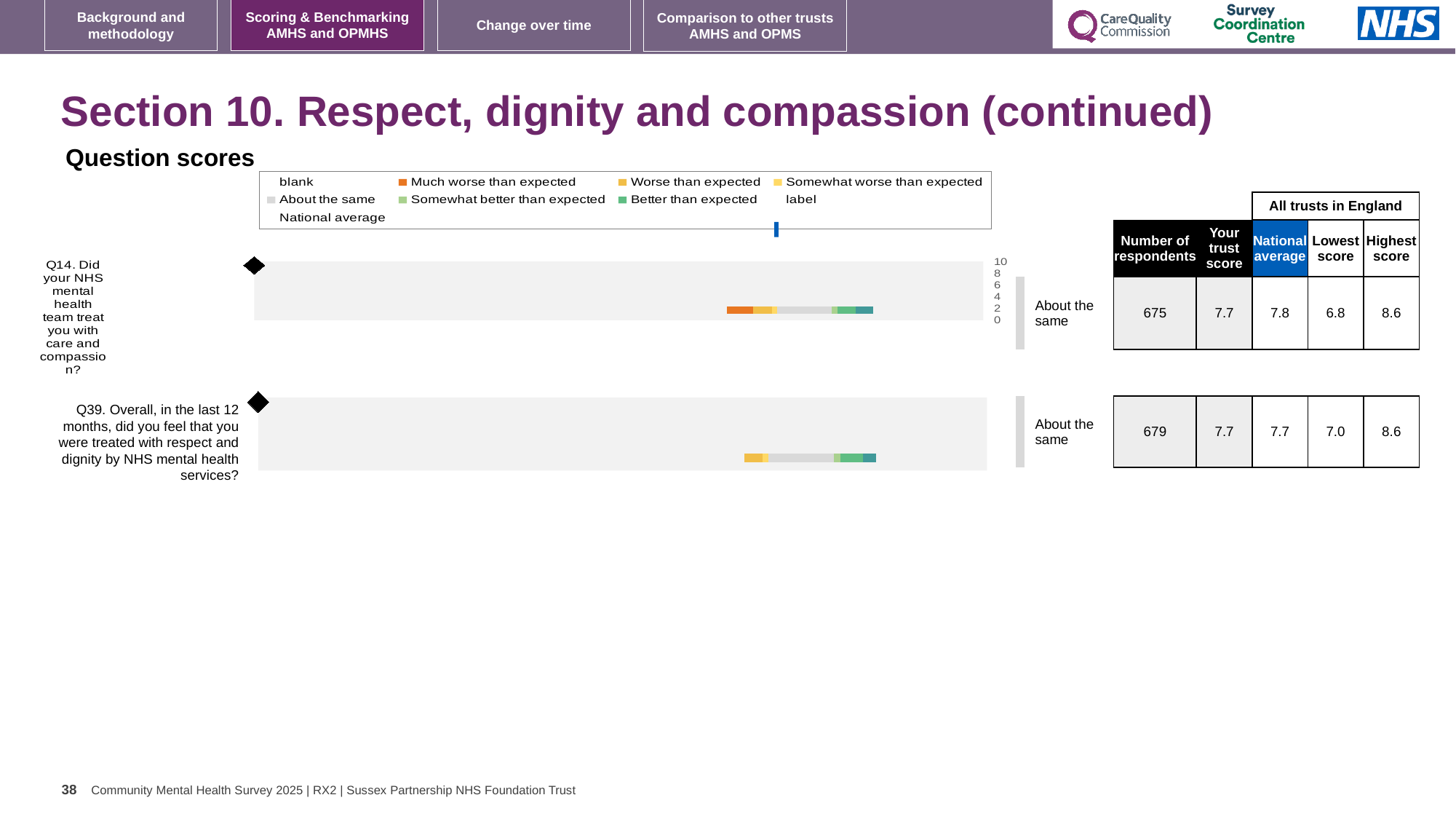
What is the lowest score among all trusts in England for Q39? 7.0 What kind of chart is used to show the question scores on this slide? bar chart What benchmark category is shown next to the bar for Q14? About the same What is the national average for Q14? 7.8 Which question has the larger lowest score, Q14 or Q39? Q39 How many questions are plotted in the question scores chart? 2 What is the highest score among all trusts in England for Q14? 8.6 What is the difference between the highest and lowest scores for Q14? 1.8 What is the number of respondents for Q14? 675 How many more respondents answered Q39 than Q14? 4 What is the trust score for Q39? 7.7 How many entries does the legend of the question scores chart list? 9